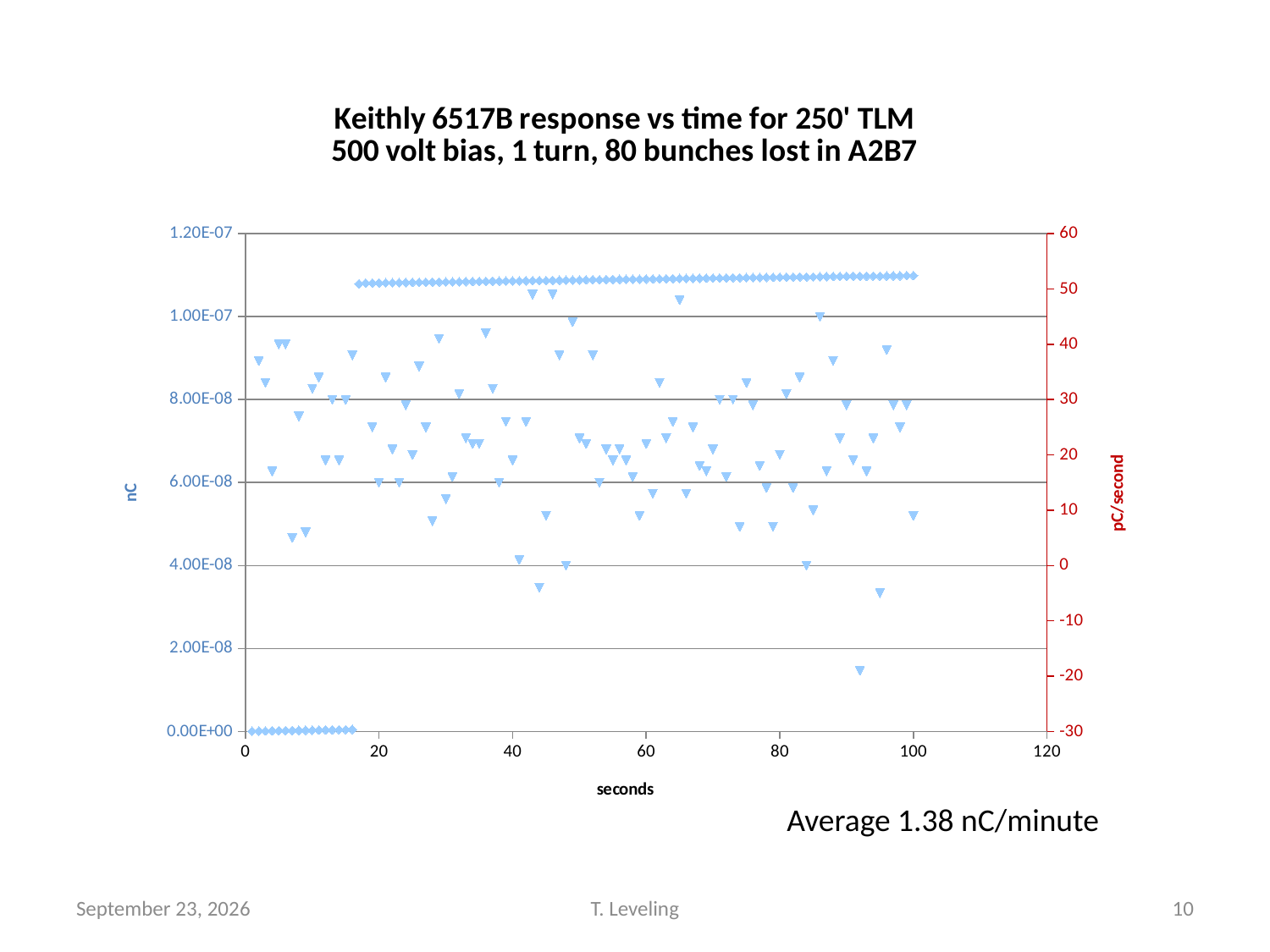
What is the maximum value shown on the x axis (seconds)? 120 What is the maximum value shown on the right vertical axis (pC/second)? 60 Is the pC/second value of the triangle near 86 seconds greater or less than 40? greater What kind of chart is shown on the slide? scatter chart Is the lowest pC/second value (the triangle near 92 seconds) greater or less than -10? less Do the nC values of the diamond series rise or fall as time increases along the x axis? rise What average value is stated below the chart? Average 1.38 nC/minute What is the label of the left vertical axis? nC Is the nC value of the diamond series at 40 seconds greater or less than 8.00E-08? greater What is the nC value of the diamond series at 10 seconds? 0.00E+00